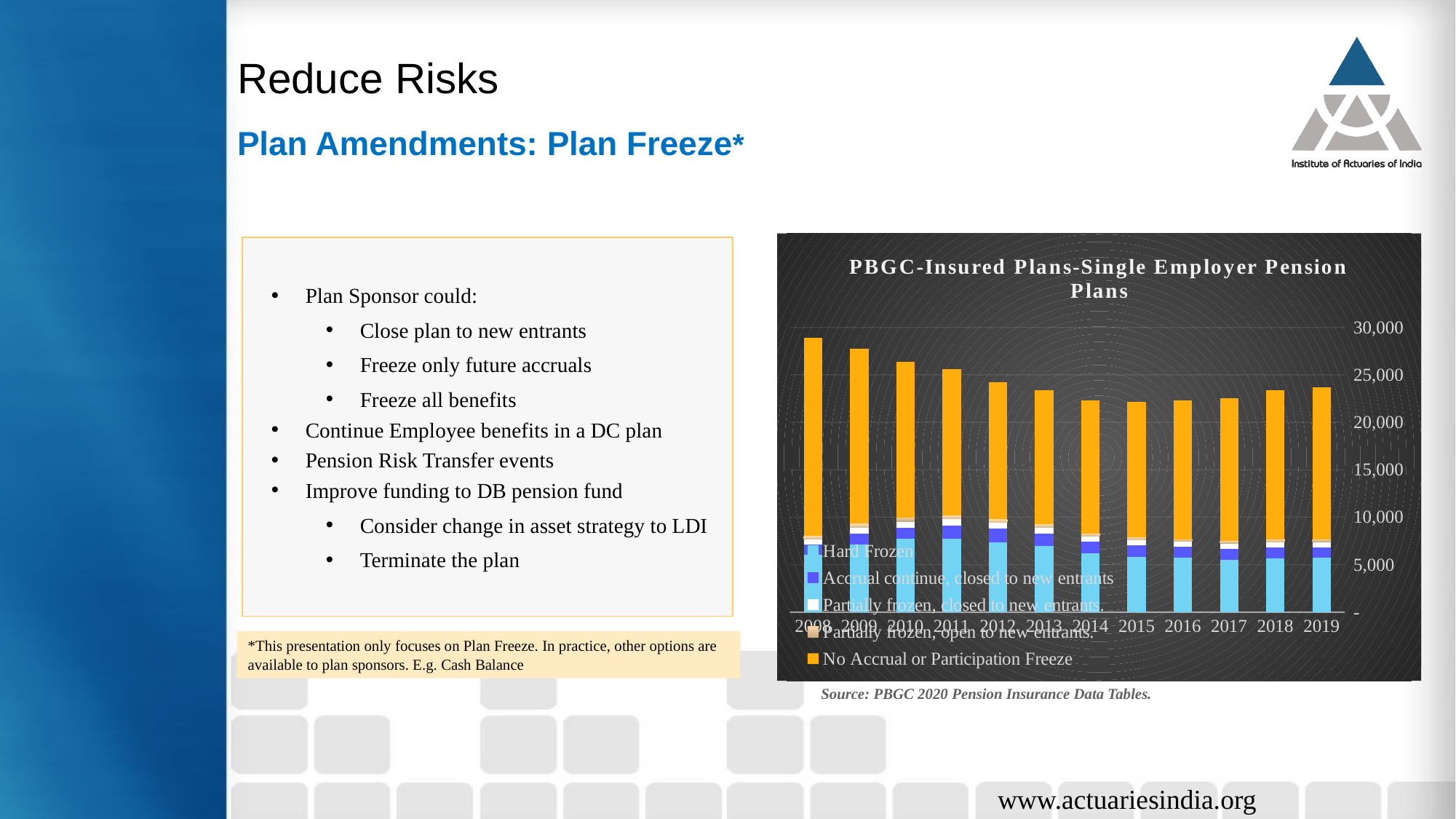
Which legend series is shown in orange in the chart? No Accrual or Participation Freeze Do the total bars generally rise or fall from 2008 to 2015? fall What kind of chart is shown on the slide? Stacked bar chart How many years are shown along the x axis of the chart? 12 Is the total bar for 2019 greater or less than 20,000? greater Is the total bar for 2008 greater or less than 25,000? greater Is the total bar for 2015 greater or less than 25,000? less Which year has the larger total bar, 2010 or 2013? 2010 What is the title of the chart? PBGC-Insured Plans-Single Employer Pension Plans Which year has the highest total bar in the chart? 2008 Which year has the larger total bar, 2008 or 2019? 2008 How many series does the chart's legend list? 5